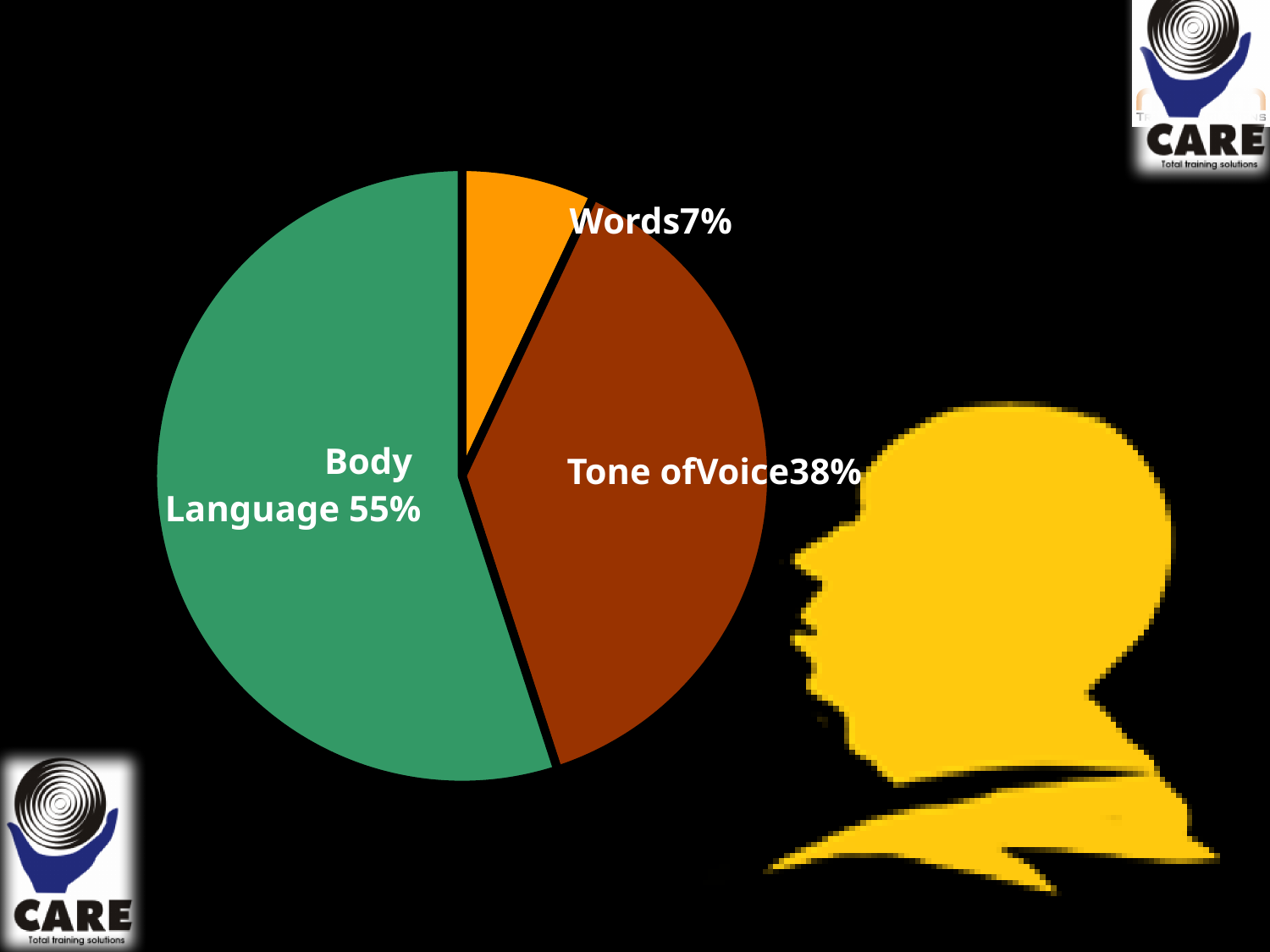
What share of the pie does Tone of Voice represent? 38% What kind of chart is shown on the slide? pie chart Which slice of the pie is the smallest? Words How many slices does the pie chart have? 3 What share of the pie does Body Language represent? 55% What colour is the Words slice? orange Which is larger, the Tone of Voice slice or the Words slice? Tone of Voice Which slice of the pie is the largest? Body Language What colour is the Body Language slice? green What share of the pie does Words represent? 7% What is the difference in percentage points between Body Language and Tone of Voice? 17 What is the difference in percentage points between Tone of Voice and Words? 31